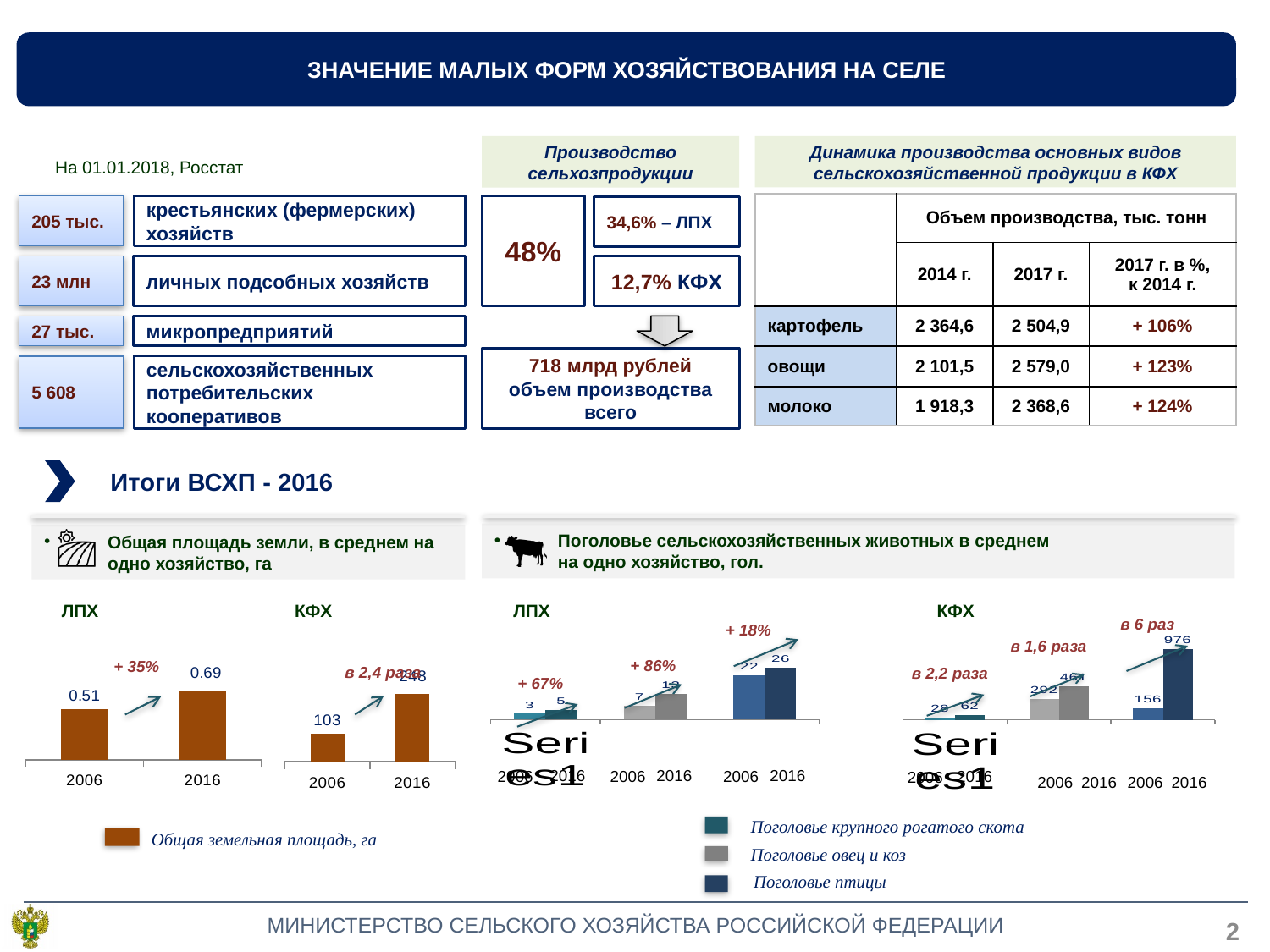
In the КФХ livestock chart (bottom right), what is the value for Поголовье птицы in 2016? 976 How many entries does the legend of the livestock charts list? 3 In the ЛПХ land area chart (bottom left), what is the value for 2006? 0.51 What kind of chart is the ЛПХ land area chart at the bottom left? bar chart In the ЛПХ livestock chart (Поголовье, ЛПХ), what is the value for Поголовье птицы in 2016? 26 In the ЛПХ livestock chart (Поголовье, ЛПХ), what is the value for Поголовье овец и коз in 2006? 7 In the КФХ livestock chart (bottom right), what is the value for Поголовье крупного рогатого скота in 2006? 28 In the КФХ land area chart (second from left at the bottom), what is the value for 2006? 103 In the ЛПХ land area chart, which year has the higher value, 2006 or 2016? 2016 In the ЛПХ land area chart (bottom left), what is the value for 2016? 0.69 In the КФХ land area chart, what is the difference between the 2016 and 2006 values? 145 In the КФХ land area chart (second from left at the bottom), what is the value for 2016? 248